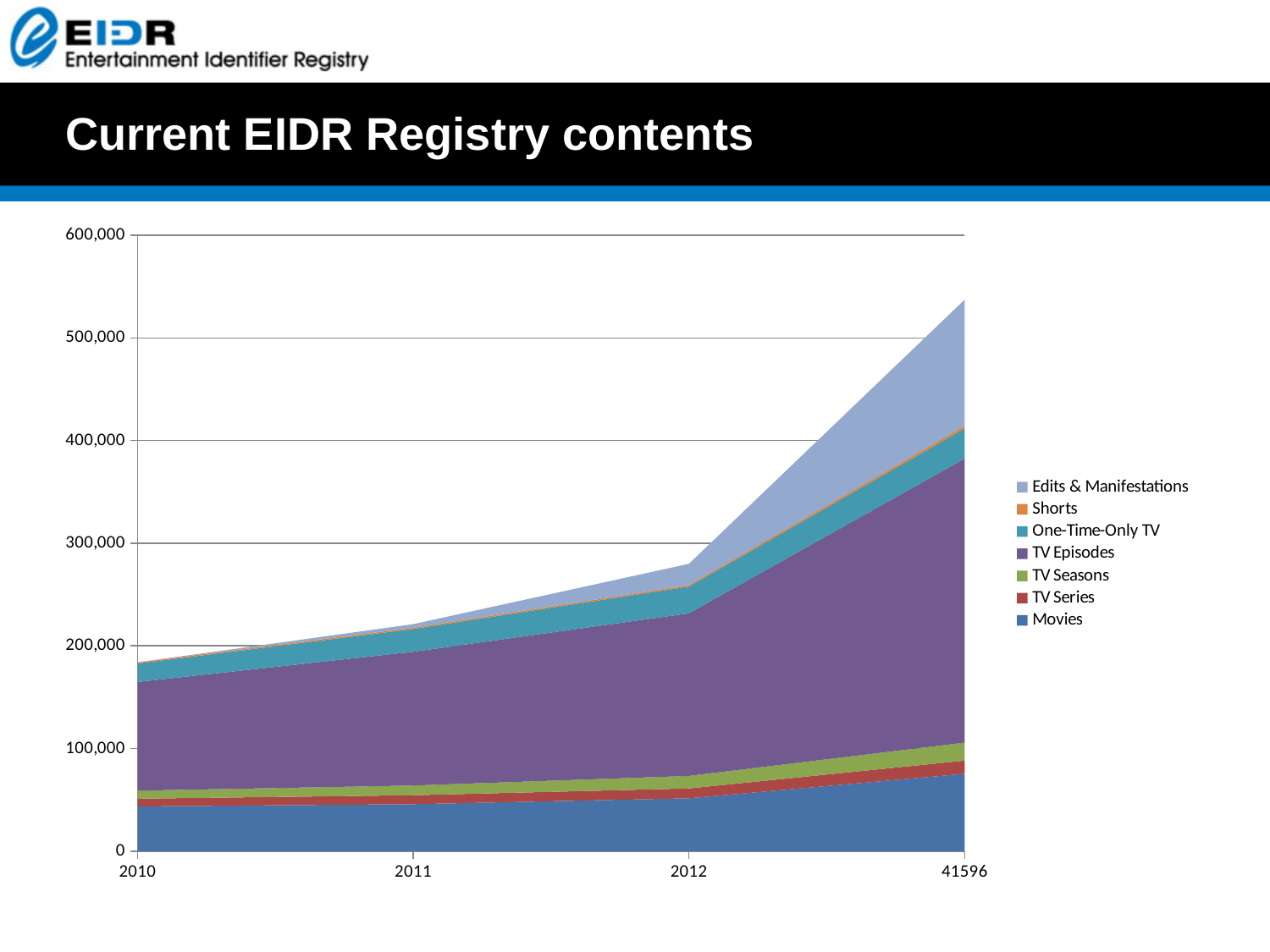
At which x-axis point is the total stacked value highest? 41596 What kind of chart is shown on the slide? Stacked area chart Is the value for Movies at 2010 greater or less than 100,000? less Do the total registry contents rise or fall from 2010 to the last point on the x axis? Rise How many series does the legend list? 7 At which x-axis point is the total stacked value lowest? 2010 Is the total stacked value at the last x-axis point (41596) greater or less than 500,000? greater Is the total stacked value at 2010 greater or less than 200,000? less How many points are plotted along the x axis? 4 What is the title of the slide containing the chart? Current EIDR Registry contents Which series is listed first (at the top) in the legend? Edits & Manifestations